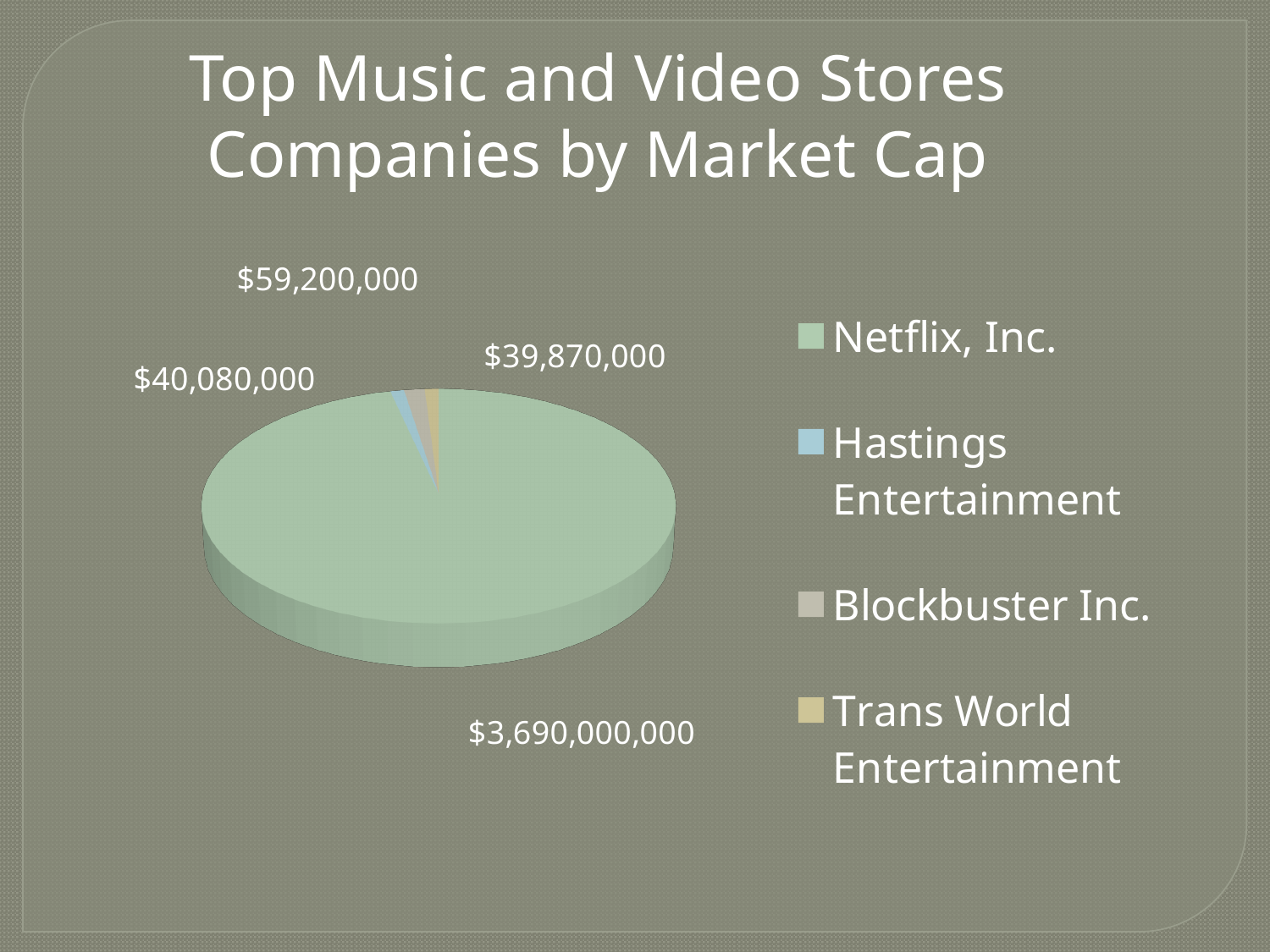
Which company is represented by the green slice in the pie chart? Netflix, Inc. Which company has the smallest market cap in the chart? Trans World Entertainment What is the market cap shown for Blockbuster Inc.? $59,200,000 What type of chart is shown on the slide? Pie chart Which has the larger market cap, Blockbuster Inc. or Hastings Entertainment? Blockbuster Inc. What is the market cap shown for Trans World Entertainment? $39,870,000 What is the difference between the market caps of Blockbuster Inc. and Hastings Entertainment? $19,120,000 Which company has the largest market cap in the chart? Netflix, Inc. What is the market cap shown for Netflix, Inc.? $3,690,000,000 How many companies are shown in the pie chart? 4 What is the market cap shown for Hastings Entertainment? $40,080,000 What is the title of the chart on the slide? Top Music and Video Stores Companies by Market Cap